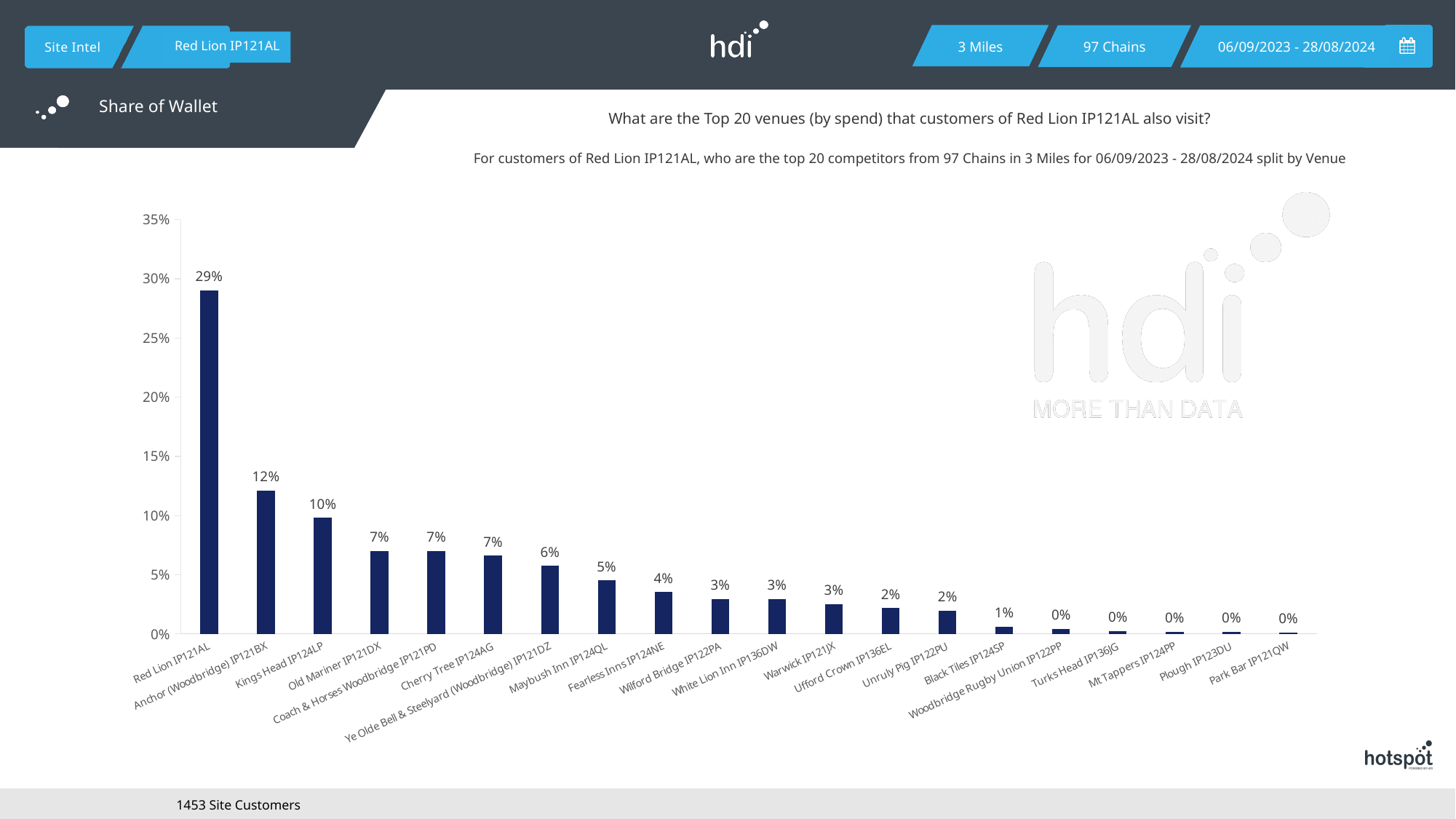
How many venues are plotted on the chart? 20 What is the value shown for Anchor (Woodbridge) IP121BX? 12% What is the value shown for Black Tiles IP124SP? 1% What kind of chart is shown on the slide? bar chart Do the values rise or fall moving from left to right along the x axis? fall What is the value shown for Red Lion IP121AL? 29% Is the value for Red Lion IP121AL greater or less than 25%? greater Which venue has the highest share of wallet on the chart? Red Lion IP121AL What is the difference between the values for Red Lion IP121AL and Anchor (Woodbridge) IP121BX? 17% What is the value shown for Kings Head IP124LP? 10% What is the value shown for Maybush Inn IP124QL? 5% Which has the larger value, Kings Head IP124LP or Old Mariner IP121DX? Kings Head IP124LP